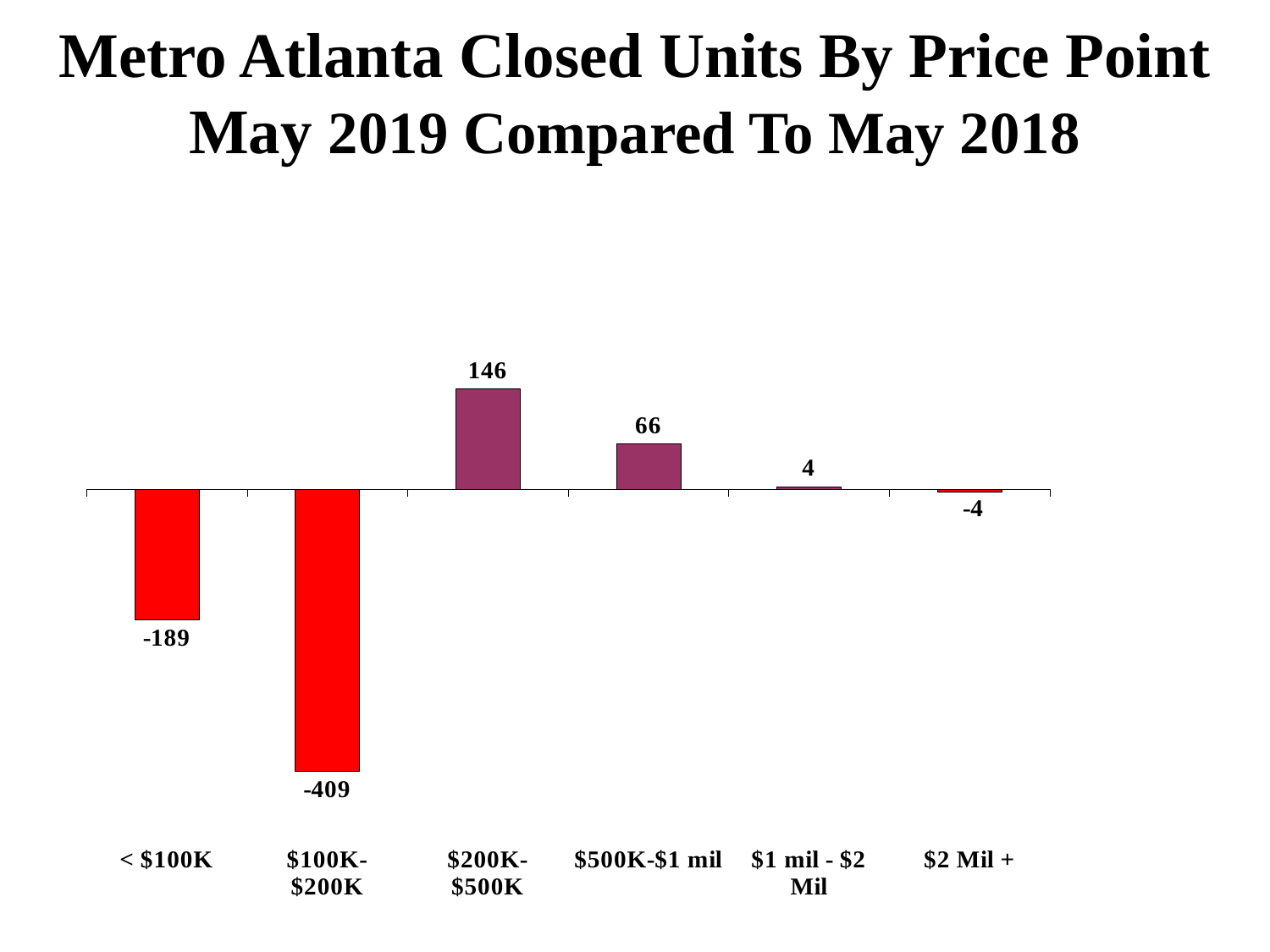
Which is larger, the value for $500K-$1 mil or the value for $1 mil - $2 Mil? $500K-$1 mil What is the value for the $200K-$500K price point? 146 What is the value for the < $100K price point? -189 What is the title of the chart? Metro Atlanta Closed Units By Price Point May 2019 Compared To May 2018 What is the difference between the values for $200K-$500K and $500K-$1 mil? 80 What is the value for the $500K-$1 mil price point? 66 What kind of chart is shown on the slide? Bar chart Which price point has the lowest value? $100K-$200K What is the value for the $2 Mil + price point? -4 How many price point categories are shown on the chart? 6 Which price point has the highest value? $200K-$500K What is the value for the $100K-$200K price point? -409